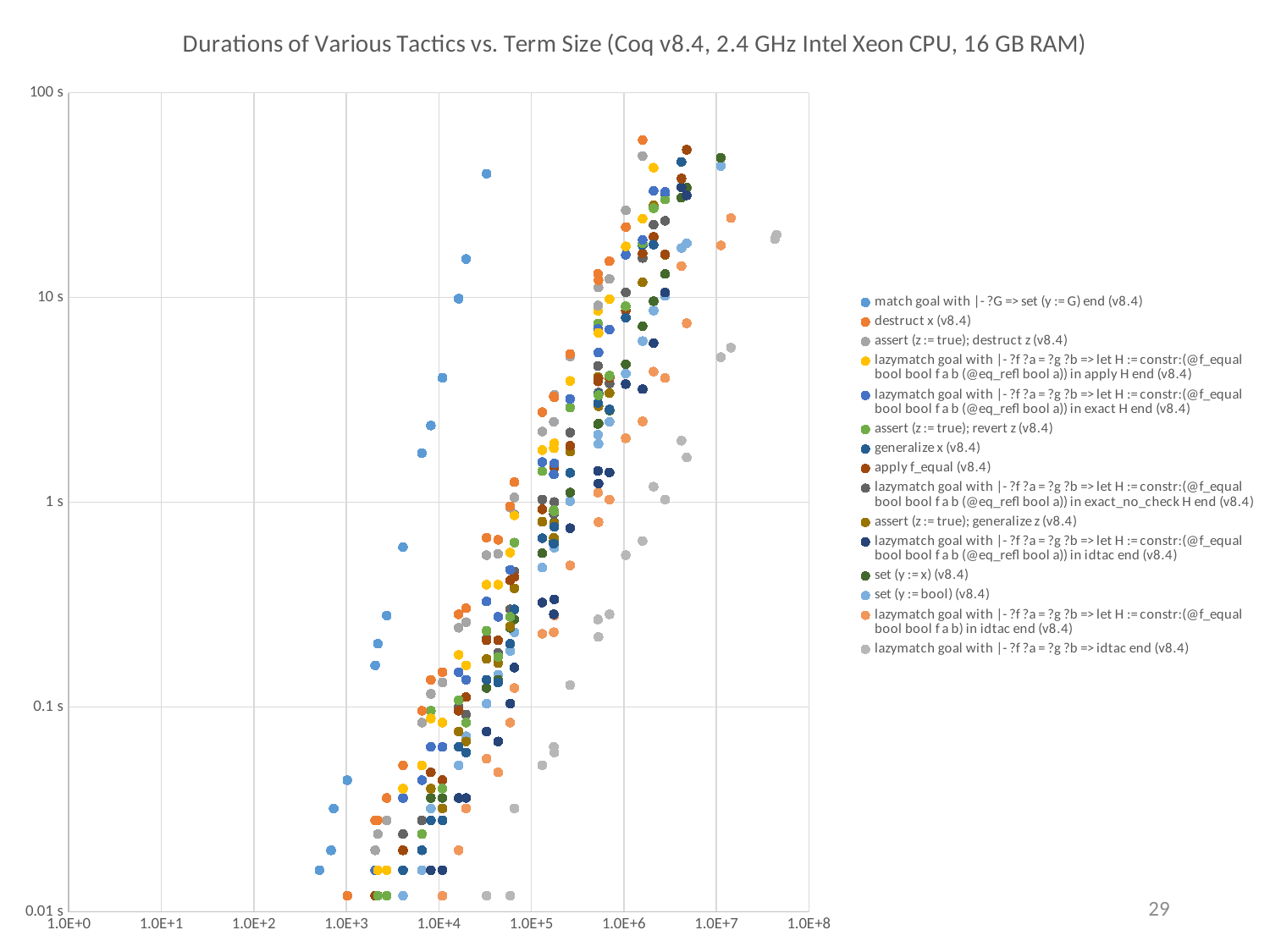
Is the largest duration plotted on the chart greater or less than 100 s? less Is the largest duration plotted on the chart greater or less than 10 s? greater How many series does the legend list? 15 What is the title of the chart? Durations of Various Tactics vs. Term Size (Coq v8.4, 2.4 GHz Intel Xeon CPU, 16 GB RAM) Which legend entry is listed first in the chart's legend? match goal with |- ?G => set (y := G) end (v8.4) What kind of chart is shown on the slide? scatter chart Do the plotted durations generally rise or fall as term size increases along the x axis? rise